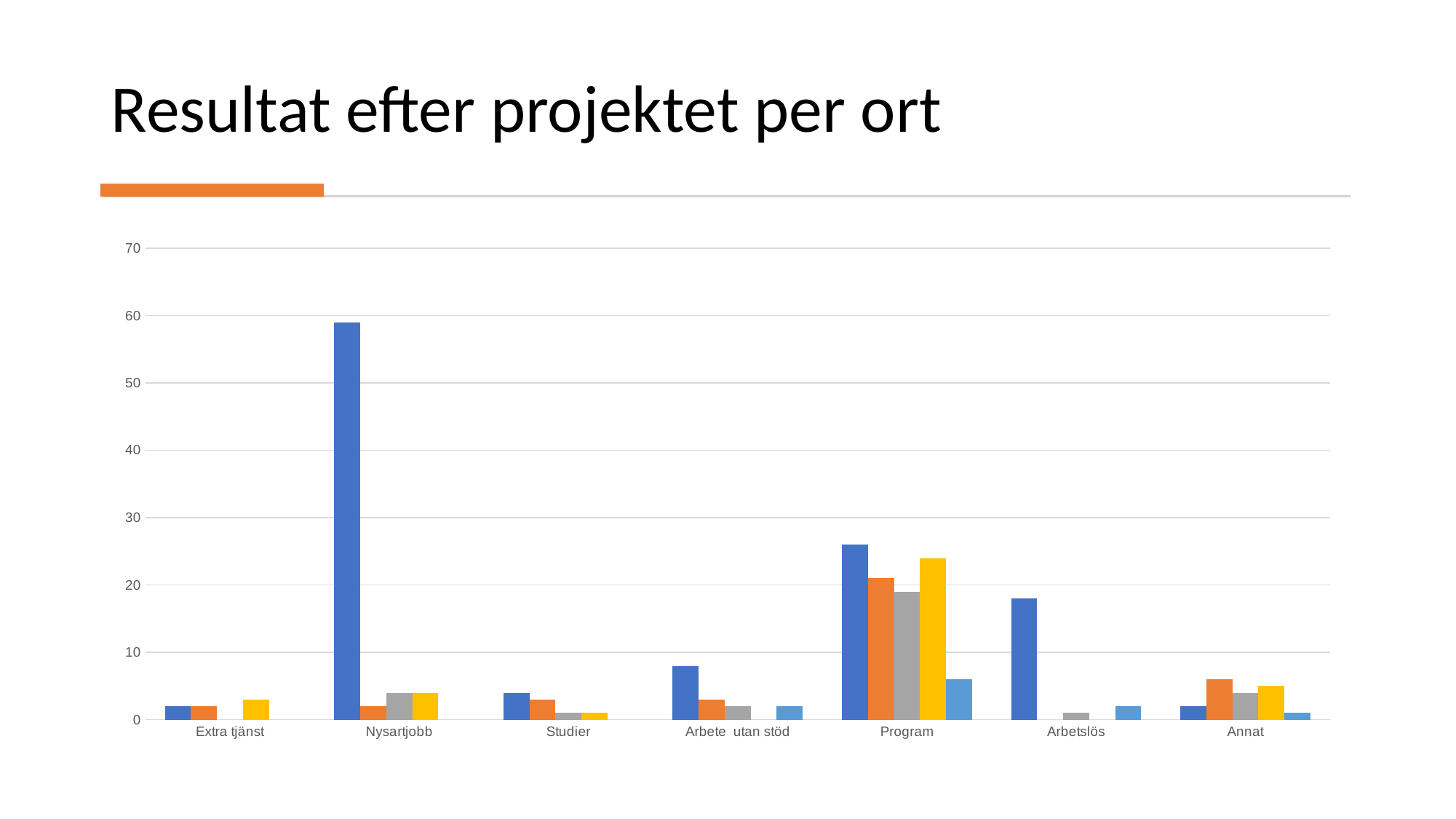
What kind of chart is shown on the slide? bar chart Is the tallest bar in the Arbetslös category greater or less than 20? less Which category contains the tallest bar in the chart? Nysartjobb How many bars are drawn in the Program category? 5 Is the tallest bar in the Extra tjänst category greater or less than 10? less Is the tallest bar in the Nysartjobb category greater or less than 50? greater Which category has the taller tallest bar, Program or Arbetslös? Program What is the title of the chart on the slide? Resultat efter projektet per ort Which category has the taller tallest bar, Nysartjobb or Program? Nysartjobb How many categories are shown along the x axis of the chart? 7